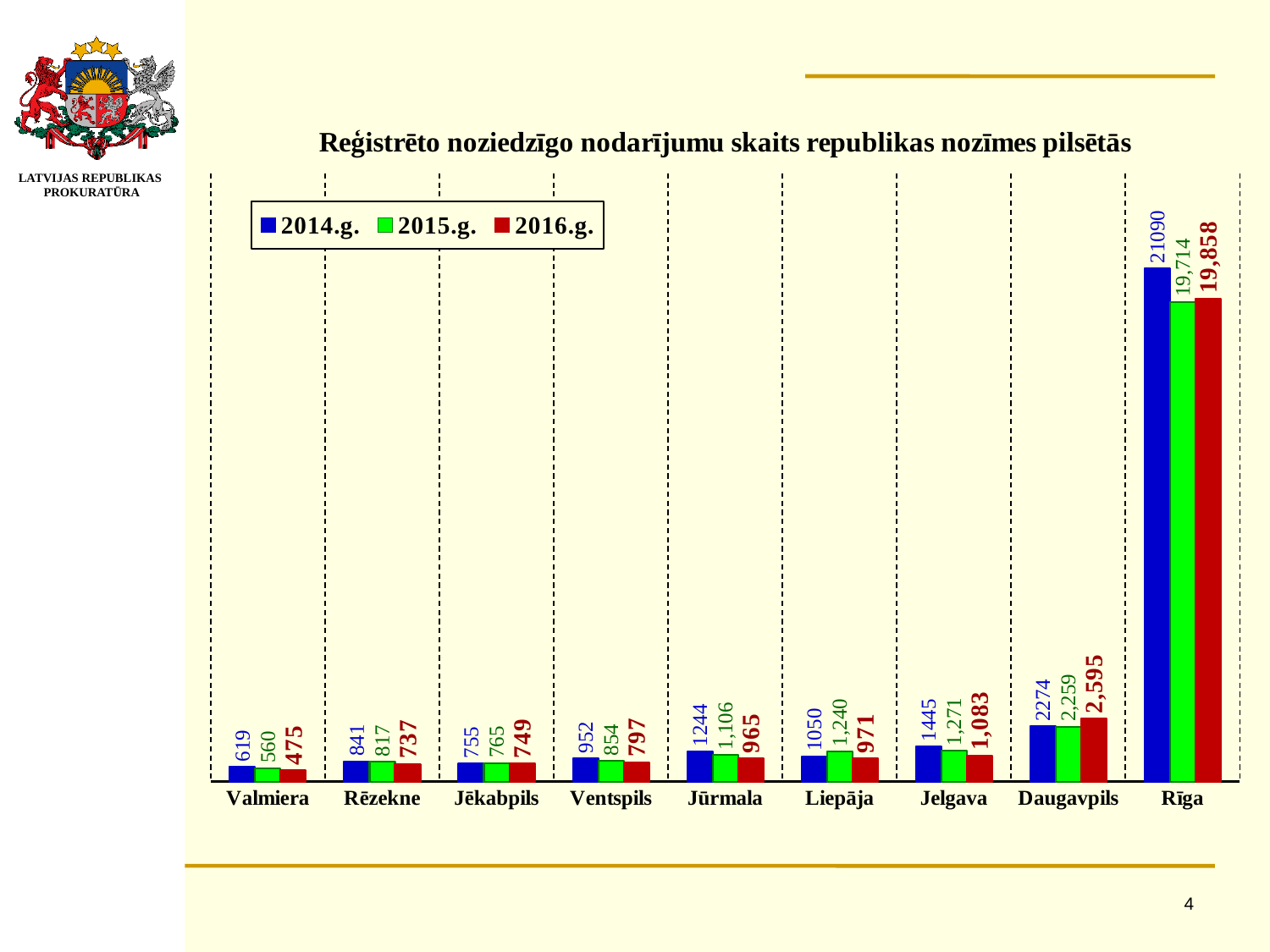
Which is larger for Jūrmala: the 2014.g. value or the 2016.g. value? 2014.g. What is the value for Daugavpils in the 2016.g. series? 2,595 What is the difference between the 2014.g. and 2016.g. values for Valmiera? 144 Which city has the lowest value in the 2014.g. series? Valmiera Which city has the highest value in the 2016.g. series? Rīga What is the value for Liepāja in the 2015.g. series? 1,240 What is the value for Rīga in the 2014.g. series? 21090 Do the values for Rēzekne rise or fall from 2014.g. to 2016.g.? Fall How many cities are shown on the x axis? 9 What kind of chart is shown on the slide? Bar chart How many series does the legend list? 3 What is the value for Valmiera in the 2016.g. series? 475